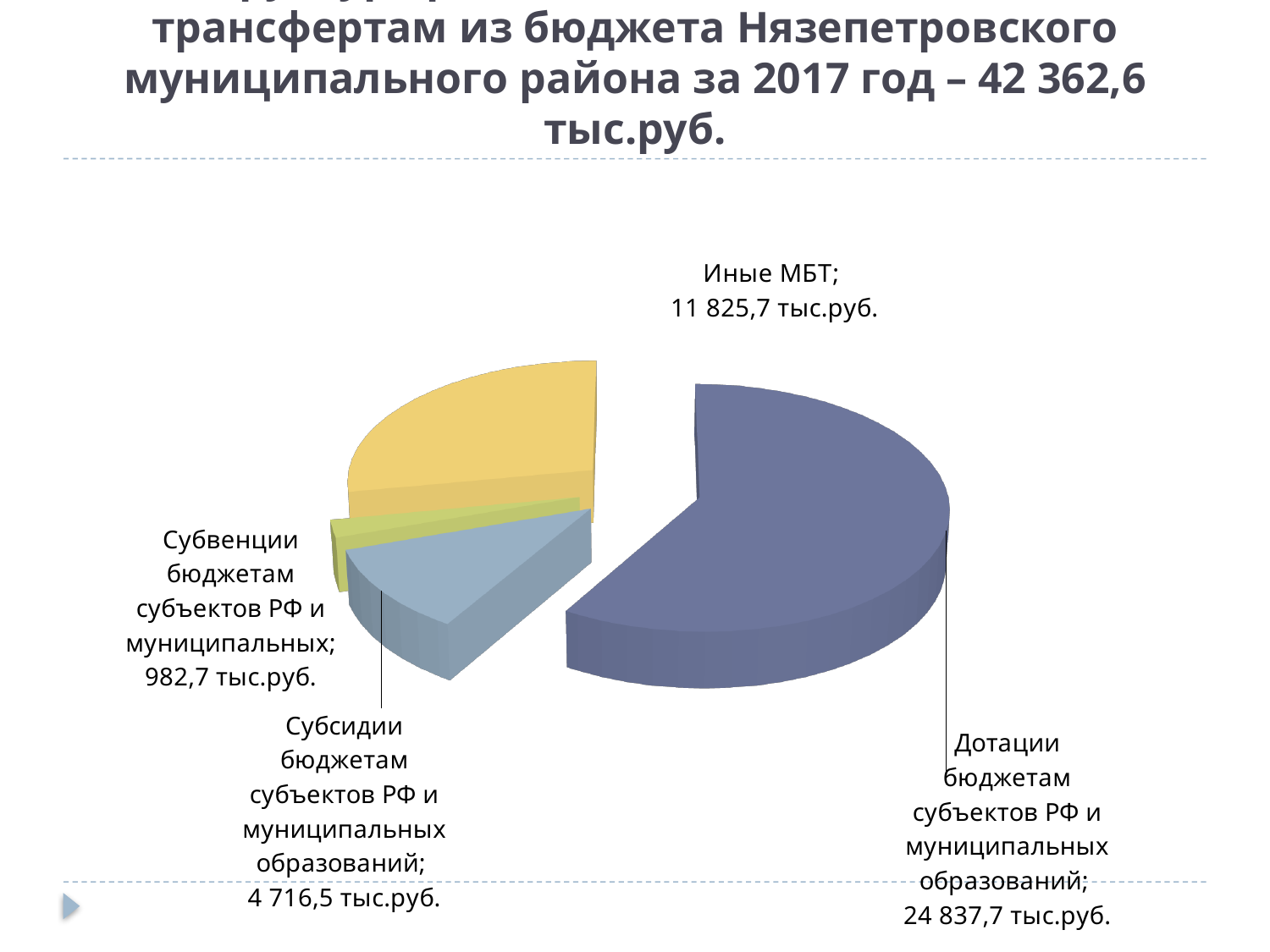
Which category has the smallest slice of the pie? Субвенции бюджетам субъектов РФ и муниципальных What is the difference between the values for Дотации and Иные МБТ? 13 012,0 тыс.руб. Which category has the largest slice of the pie? Дотации бюджетам субъектов РФ и муниципальных образований Which is larger: the value for Иные МБТ or the value for Субсидии? Иные МБТ What is the value for Субвенции бюджетам субъектов РФ и муниципальных? 982,7 тыс.руб. What share of the total 42 362,6 тыс.руб. does the Дотации slice represent? 58,6% What total amount of transfers for 2017 is stated in the slide title? 42 362,6 тыс.руб. How many slices does the pie chart have? 4 What is the value for Иные МБТ? 11 825,7 тыс.руб. What is the value for Субсидии бюджетам субъектов РФ и муниципальных образований? 4 716,5 тыс.руб. What is the value for Дотации бюджетам субъектов РФ и муниципальных образований? 24 837,7 тыс.руб. What kind of chart is shown on the slide? pie chart